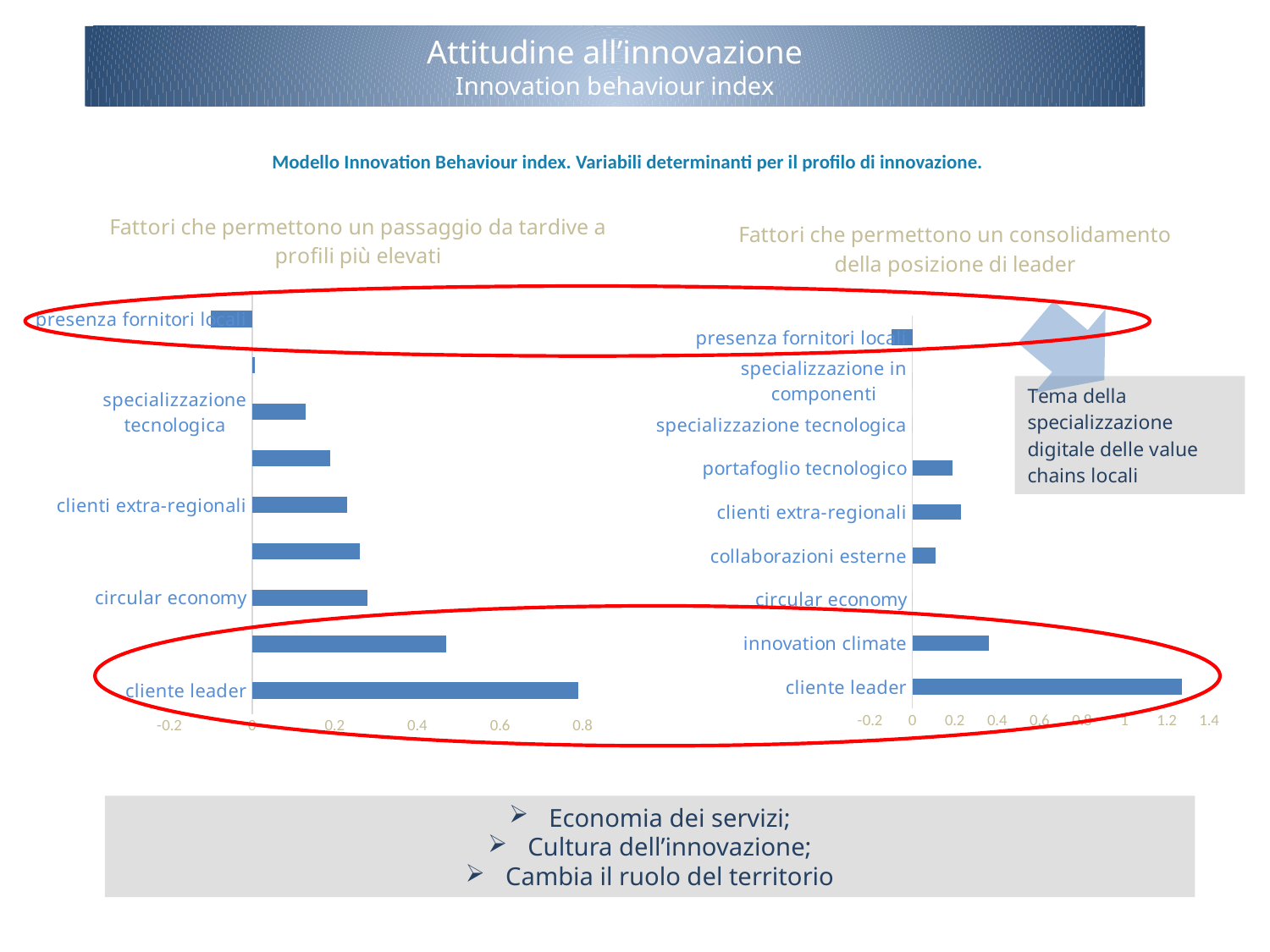
In the left chart, 'Fattori che permettono un passaggio da tardive a profili più elevati', is the value for specializzazione tecnologica greater or less than 0.2? less In the right chart, 'Fattori che permettono un consolidamento della posizione di leader', is the value for cliente leader greater or less than 1? greater In the left chart, 'Fattori che permettono un passaggio da tardive a profili più elevati', which category has the lowest value? presenza fornitori locali In the right chart, 'Fattori che permettono un consolidamento della posizione di leader', which is larger: clienti extra-regionali or collaborazioni esterne? clienti extra-regionali In the left chart, 'Fattori che permettono un passaggio da tardive a profili più elevati', which category has the highest value? cliente leader In the left chart, 'Fattori che permettono un passaggio da tardive a profili più elevati', is the value for cliente leader greater or less than 0.6? greater In the left chart, 'Fattori che permettono un passaggio da tardive a profili più elevati', which is larger: cliente leader or circular economy? cliente leader In the right chart, 'Fattori che permettono un consolidamento della posizione di leader', how many categories are listed on the vertical axis? 9 What kind of chart is the left chart, 'Fattori che permettono un passaggio da tardive a profili più elevati'? bar chart In the right chart, 'Fattori che permettono un consolidamento della posizione di leader', which category has the highest value? cliente leader In the right chart, 'Fattori che permettono un consolidamento della posizione di leader', which category has the lowest value? presenza fornitori locali